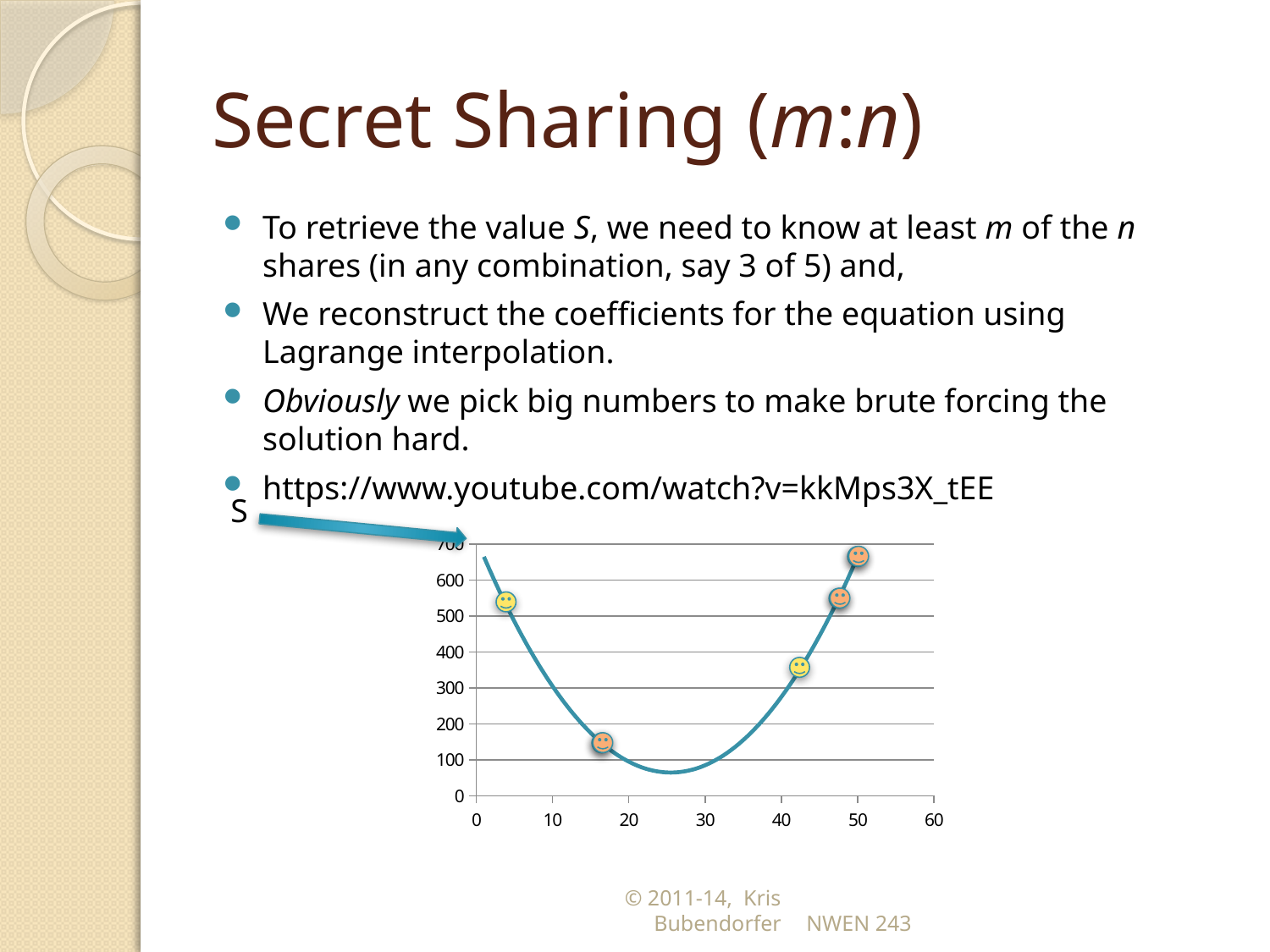
Which marked point on the curve has the lowest value? The one near x = 16 Does the curve rise or fall as x increases from 0 to 20? Falls Does the curve rise or fall as x increases from 30 to 50? Rises Which marked point on the curve has the highest value? The one near x = 50 Is the value of the marked point near x = 42 greater or less than 400? less Is the value of the leftmost marked point (near x = 4) greater or less than 500? greater Is the value of the marked point near x = 16 greater or less than 200? less How many marked points (smiley faces) lie on the curve? 5 What kind of chart is shown on the slide? A line chart (smooth curve with marked points) What is the largest value labelled on the x axis? 60 Which marked point has the highest value: the one near x = 16 or the one near x = 50? The one near x = 50